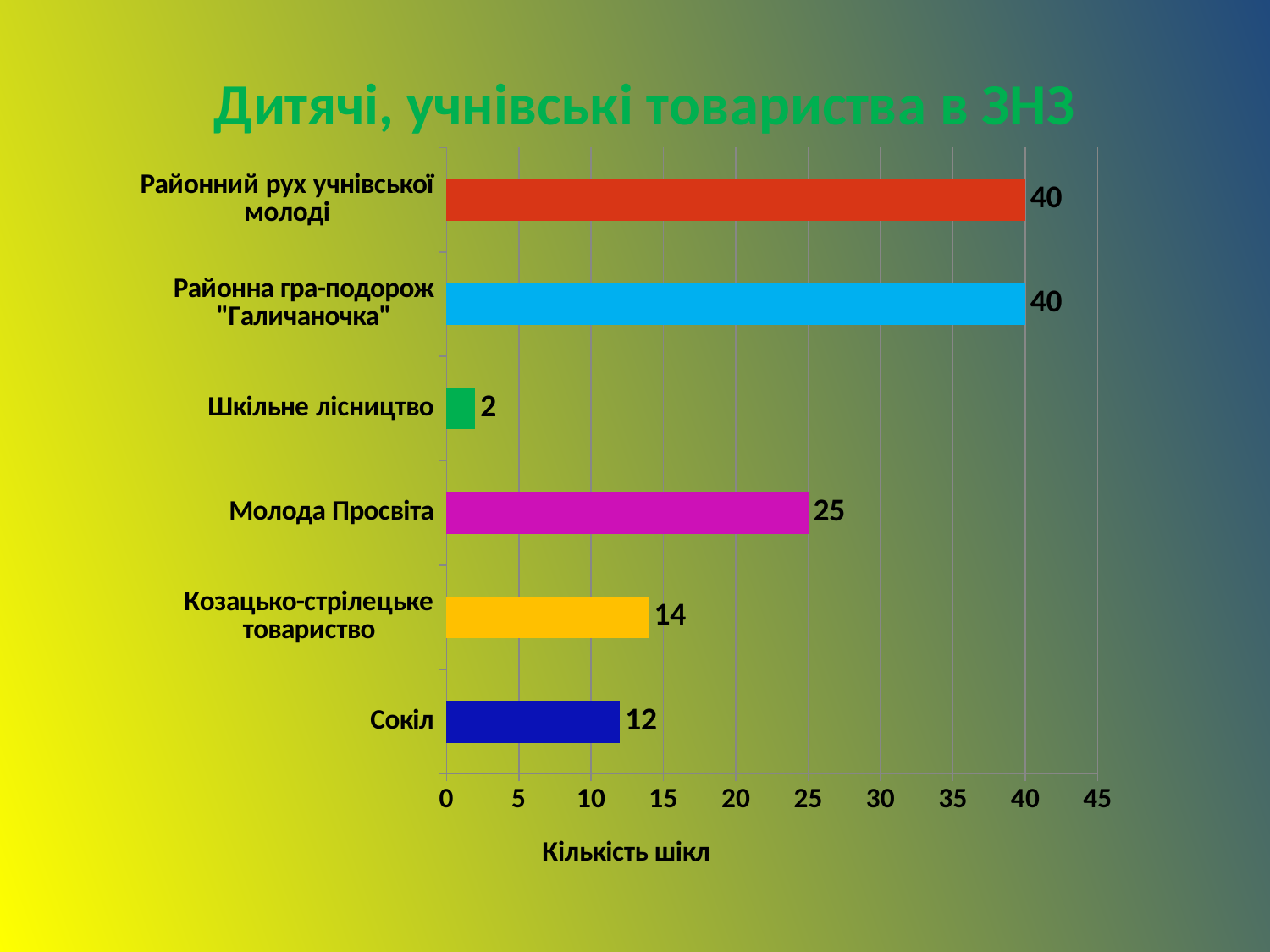
What is the value for Районна гра-подорож "Галичаночка"? 40 What is the value for Шкільне лісництво? 2 What kind of chart is shown on the slide? bar chart How many categories are plotted in the chart? 6 What is the title of the chart? Дитячі, учнівські товариства в ЗНЗ What is the value for Молода Просвіта? 25 Which category has the lowest value? Шкільне лісництво What is the difference between the values for Молода Просвіта and Сокіл? 13 What is the value for Сокіл? 12 What is the difference between the values for Районний рух учнівської молоді and Козацько-стрілецьке товариство? 26 What is the value for Козацько-стрілецьке товариство? 14 Which is larger, the value for Козацько-стрілецьке товариство or the value for Сокіл? Козацько-стрілецьке товариство